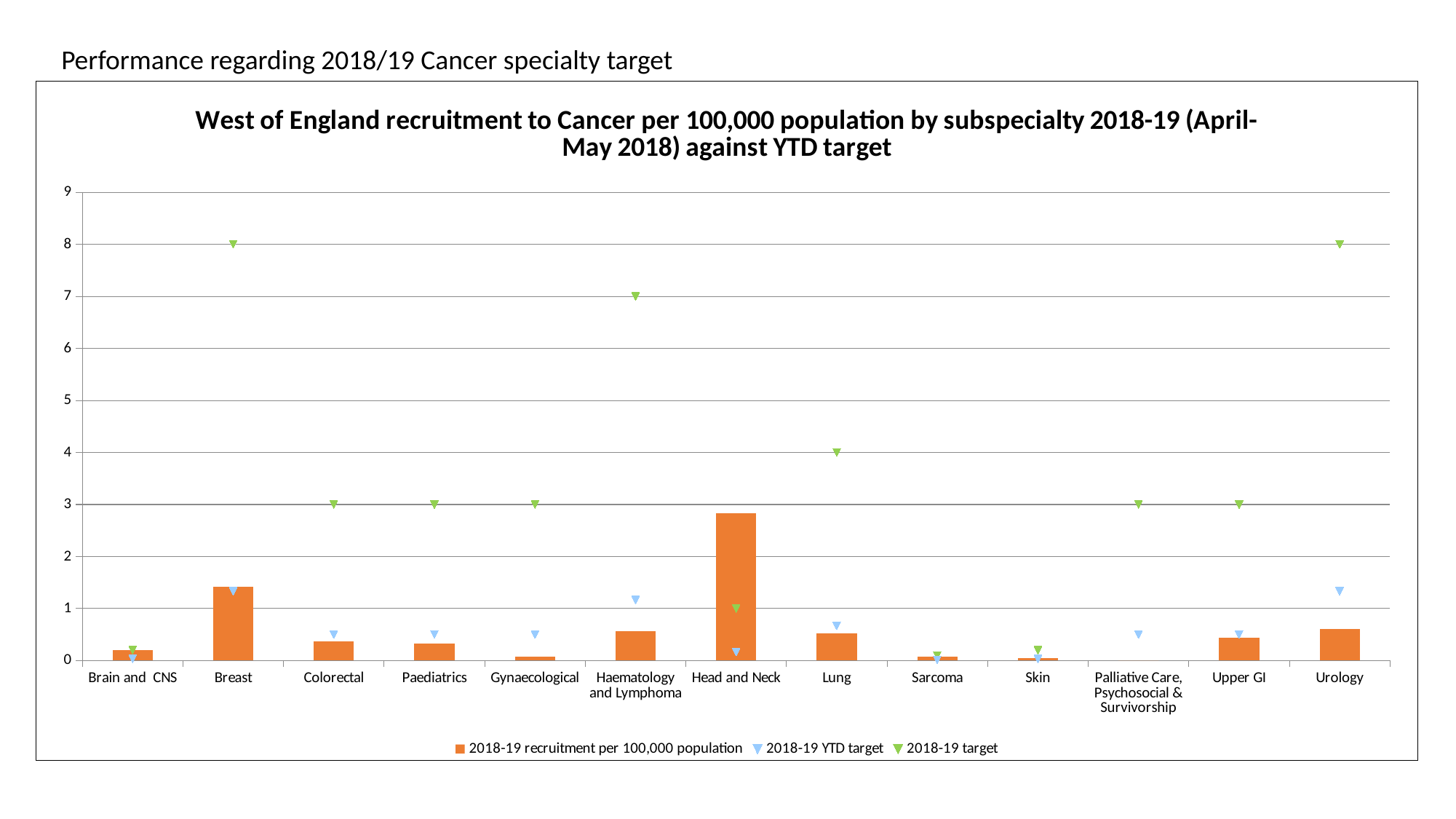
What is the 2018-19 target value for Haematology and Lymphoma? 7 What is the 2018-19 target value for Breast? 8 What is the title of the chart? West of England recruitment to Cancer per 100,000 population by subspecialty 2018-19 (April-May 2018) against YTD target What is the 2018-19 target value for Head and Neck? 1 What kind of chart is shown on the slide? bar chart Is the 2018-19 recruitment per 100,000 population for Breast greater or less than 1? greater What is the 2018-19 target value for Lung? 4 Which subspecialty has the highest 2018-19 recruitment per 100,000 population? Head and Neck How many subspecialty categories are shown on the x axis? 13 How many series does the legend list? 3 Which has the larger 2018-19 recruitment per 100,000 population, Breast or Colorectal? Breast Is the 2018-19 recruitment per 100,000 population for Head and Neck greater or less than 2? greater